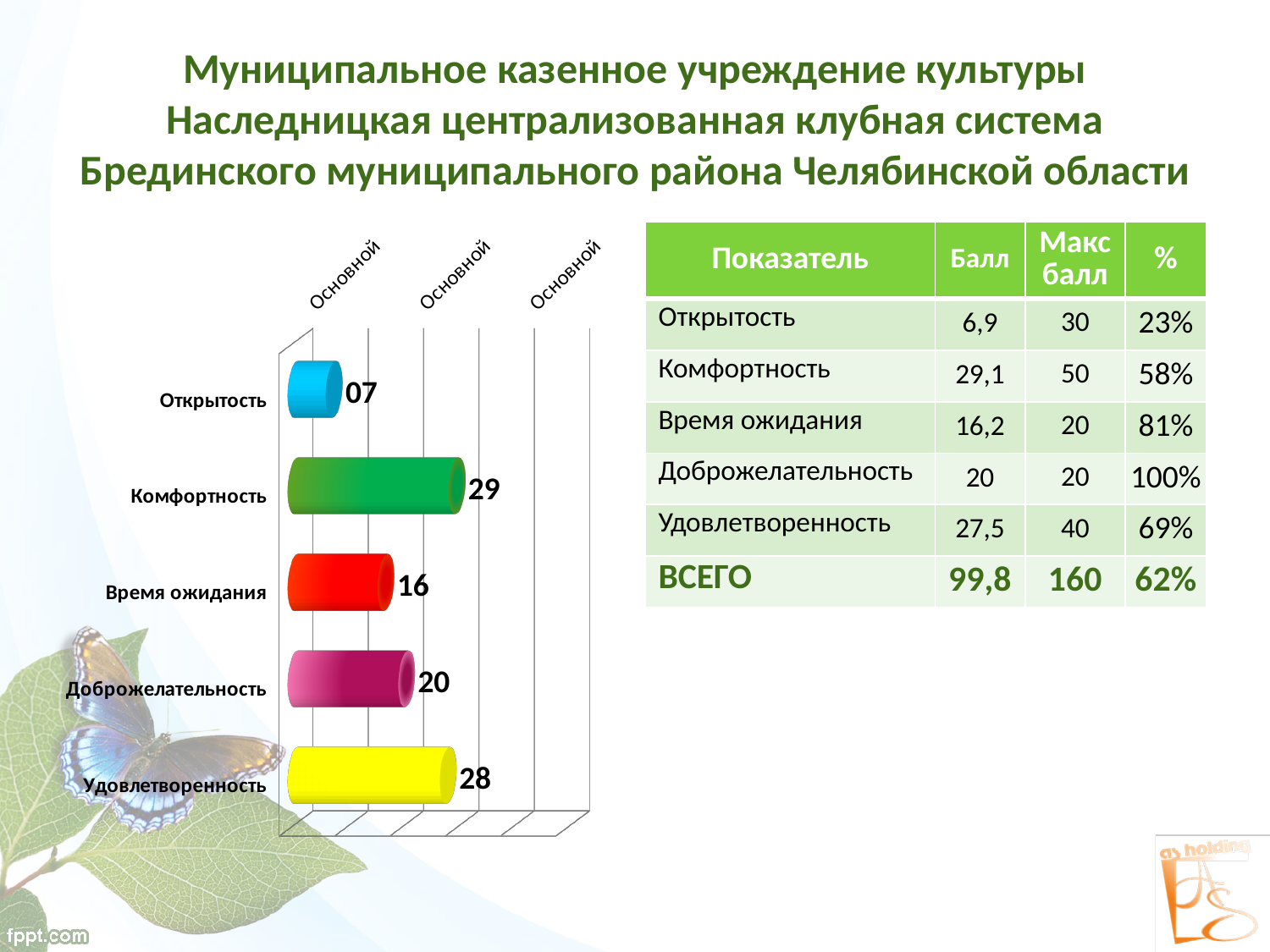
What is the data label shown on the bar for Открытость? 07 What value is printed on the bar for Комфортность? 29 What value is printed on the bar for Время ожидания? 16 What is the difference between the values for Комфортность and Удовлетворенность? 1 Which category has the lowest value in the chart? Открытость Which category has the highest value in the chart? Комфортность What is the difference between the values for Доброжелательность and Время ожидания? 4 Which is larger, the value for Доброжелательность or the value for Время ожидания? Доброжелательность What value is printed on the bar for Удовлетворенность? 28 What type of chart is shown on the slide? Bar chart What colour is the bar for Удовлетворенность? Yellow How many categories are plotted in the chart? 5